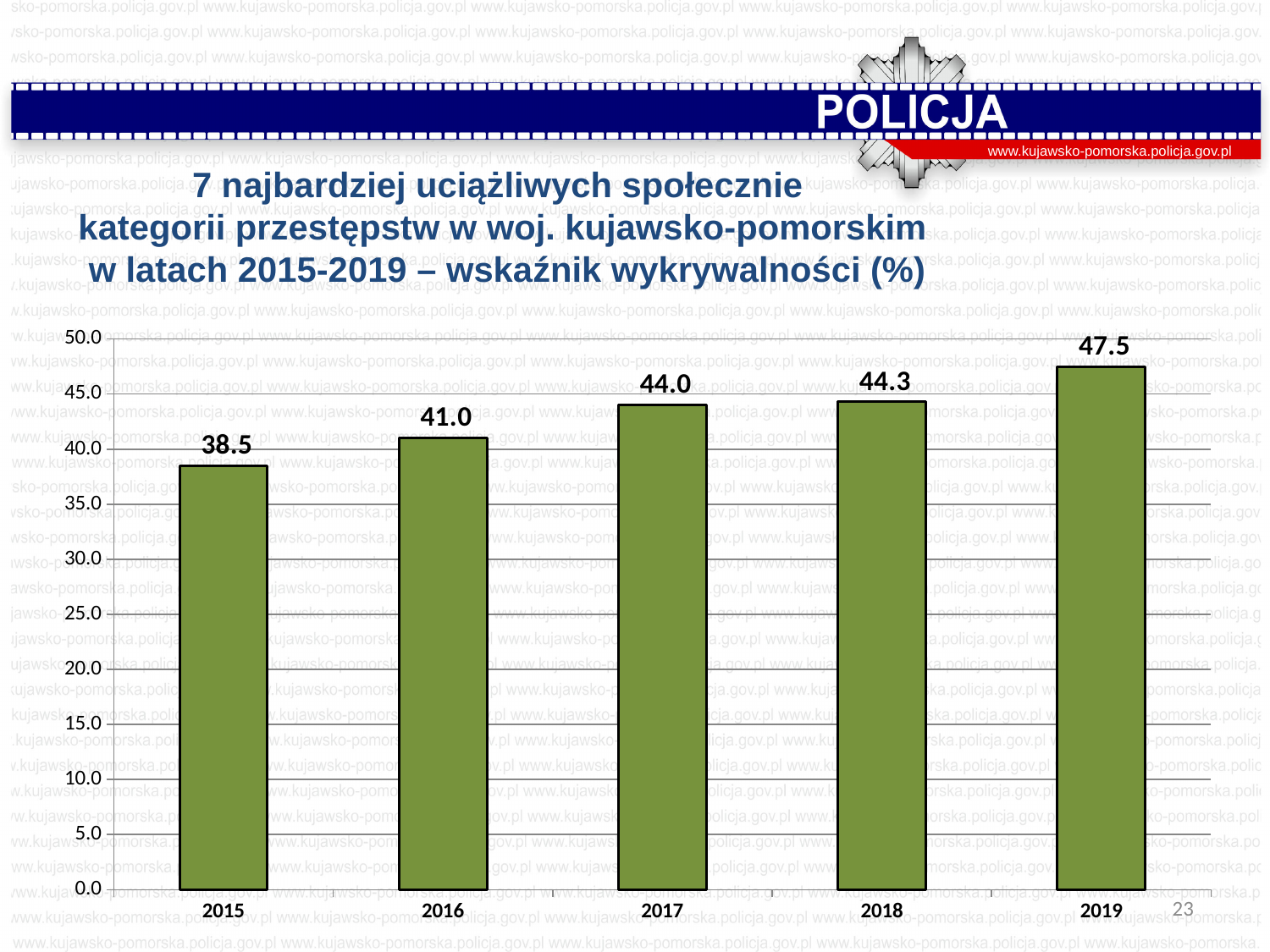
What is the difference between the values for 2019 and 2015? 9.0 Which year has the highest value? 2019 What is the detection rate value shown for 2015? 38.5 Do the values generally rise or fall from 2015 to 2019? rise Which is larger, the value for 2016 or the value for 2018? 2018 What kind of chart is shown on the slide? bar chart How many years are shown on the x axis? 5 Which year has the lowest value? 2015 Is the value for 2018 greater or less than 40.0? greater What is the value shown for 2017? 44.0 What is the difference between the values for 2016 and 2015? 2.5 What is the value shown for 2019? 47.5